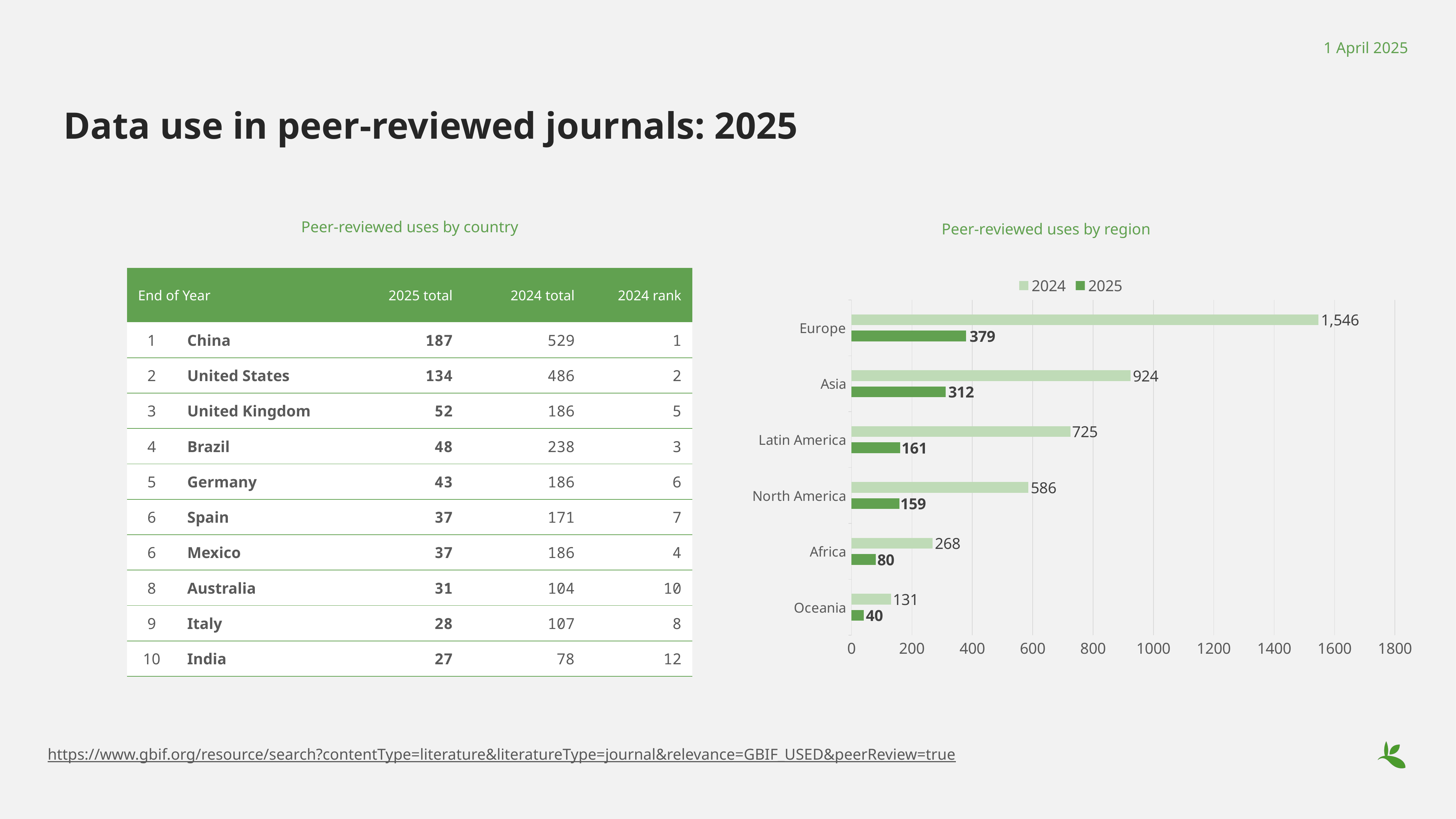
In the 'Peer-reviewed uses by region' chart, which region has the highest 2024 value? Europe In the 'Peer-reviewed uses by region' chart, which is larger: the 2025 value for North America or the 2025 value for Africa? North America In the 'Peer-reviewed uses by region' chart, what is the difference between the 2024 and 2025 values for Latin America? 564 How many series does the legend of the 'Peer-reviewed uses by region' chart list? 2 In the 'Peer-reviewed uses by region' chart, what is the 2024 value for Europe? 1,546 In the 'Peer-reviewed uses by region' chart, is the 2024 value for Asia greater or less than 800? greater In the 'Peer-reviewed uses by region' chart, which series is shown in the darker green? 2025 In the 'Peer-reviewed uses by region' chart, what is the 2025 value for Asia? 312 In the 'Peer-reviewed uses by region' chart, which region has the lowest 2025 value? Oceania In the 'Peer-reviewed uses by region' chart, what is the 2025 value for Oceania? 40 What type of chart is 'Peer-reviewed uses by region'? Bar chart How many regions are shown in the 'Peer-reviewed uses by region' chart? 6